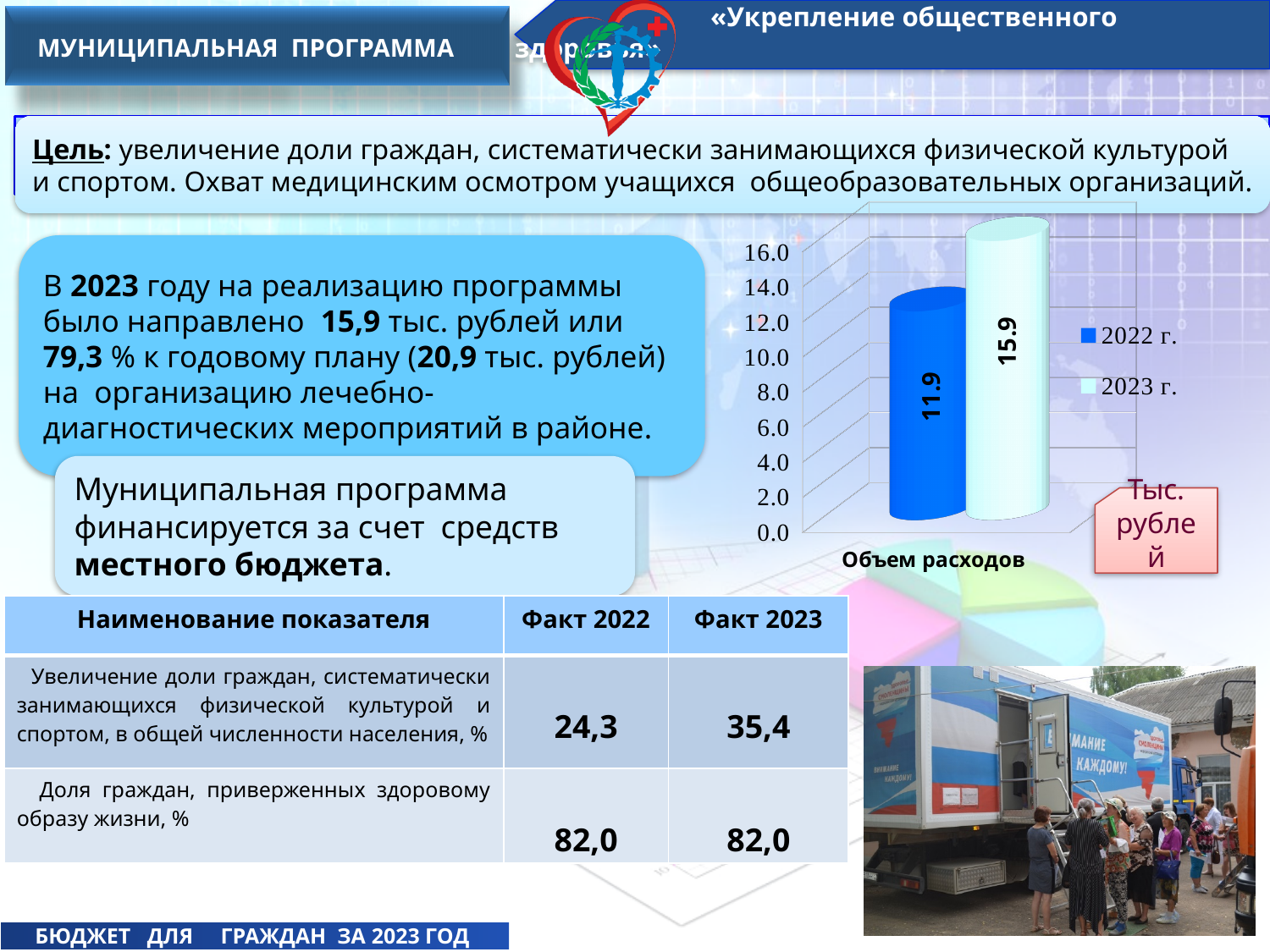
What is the difference between the 2023 г. and 2022 г. values in the chart? 4.0 How many series does the chart legend list? 2 What is the value for 2022 г. in the chart? 11.9 Which year has the higher value in the chart, 2022 г. or 2023 г.? 2023 г. Is the value for 2023 г. greater or less than 14.0? greater What is the maximum value shown on the chart's vertical axis? 16.0 Which series has the lowest value in the chart? 2022 г. What kind of chart is shown on the slide? bar chart What is the value for 2023 г. in the chart? 15.9 Is the value for 2022 г. greater or less than 12.0? less What is the category label shown below the bars in the chart? Объем расходов Which series has the highest value in the chart? 2023 г.